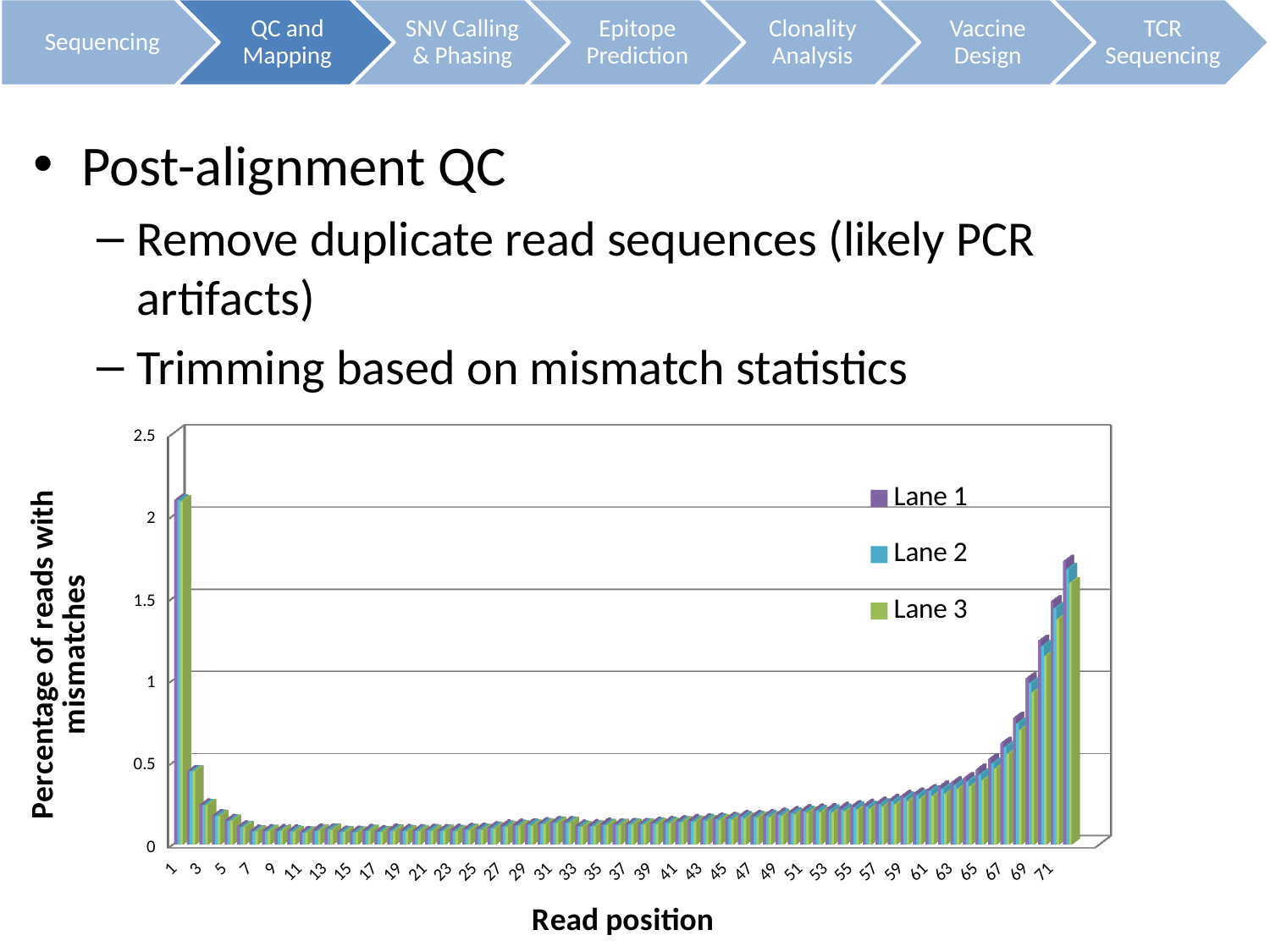
Is the Lane 1 value at read position 5 greater or less than 0.5? less Is the Lane 1 value at read position 41 greater or less than 0.5? less Do the values rise or fall along the x axis from read position 41 to read position 71? rise What are the series names listed in the chart's legend? Lane 1, Lane 2, Lane 3 Is the Lane 1 value at read position 1 greater or less than 1.5? greater How many series does the chart's legend list? 3 Do the values rise or fall along the x axis from read position 1 to read position 9? fall What is the title of the chart's vertical axis? Percentage of reads with mismatches What kind of chart is shown on the slide? bar chart Which is larger for Lane 1: the value at read position 1 or at read position 71? read position 1 Which read position has the highest percentage of reads with mismatches? 1